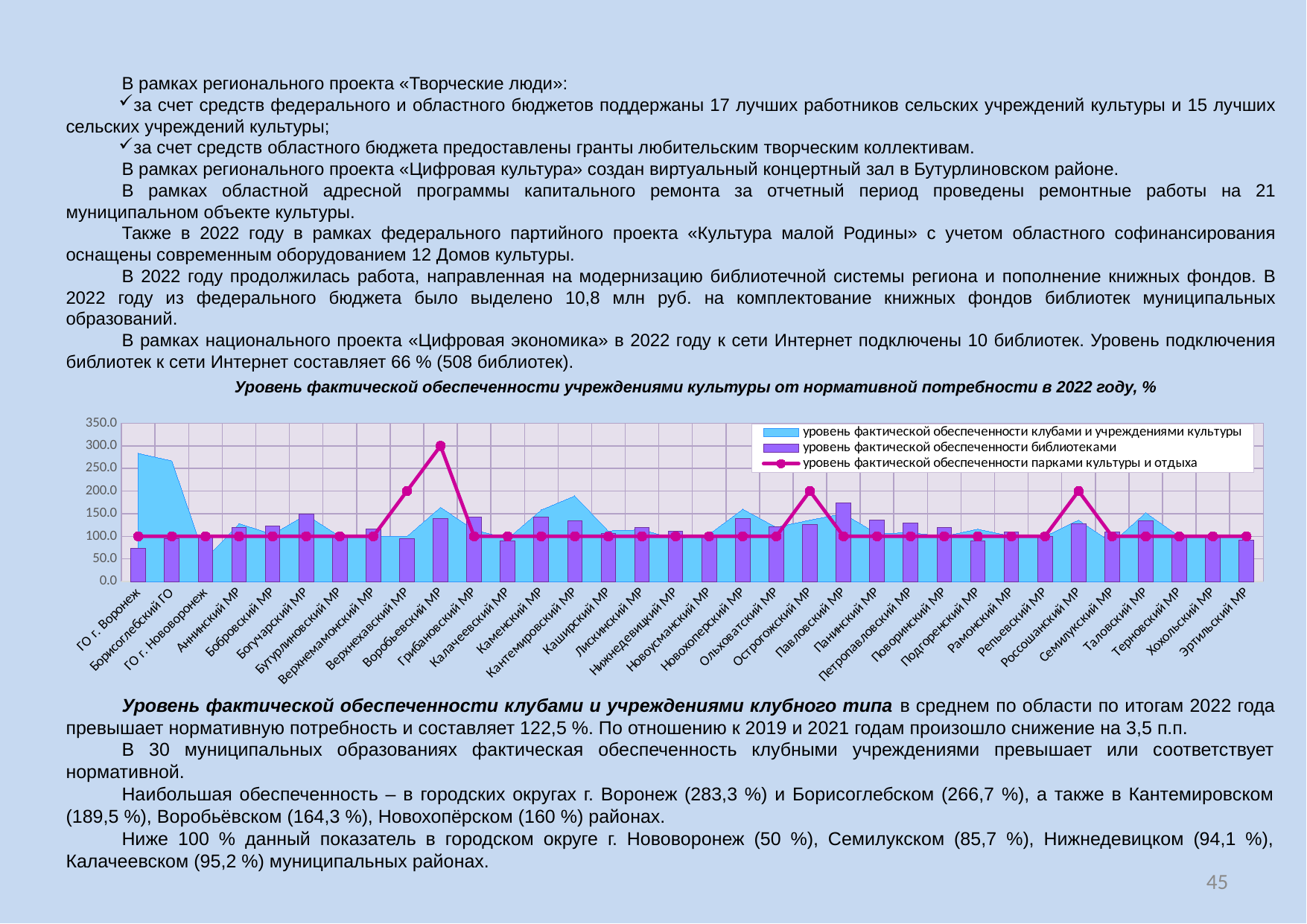
What is the title of the chart? Уровень фактической обеспеченности учреждениями культуры от нормативной потребности в 2022 году, % Which municipality has the highest value for 'уровень фактической обеспеченности клубами и учреждениями культуры'? ГО г. Воронеж Which municipality has the highest value for 'уровень фактической обеспеченности парками культуры и отдыха'? Воробьевский МР What is the value for 'уровень фактической обеспеченности парками культуры и отдыха' for Воробьевский МР? 300.0 What kind of chart is used for the series 'уровень фактической обеспеченности парками культуры и отдыха'? line chart What is the value for 'уровень фактической обеспеченности парками культуры и отдыха' for Верхнехавский МР? 200.0 Is the value for 'уровень фактической обеспеченности клубами и учреждениями культуры' for ГО г. Нововоронеж greater or less than 100? less Is the value for 'уровень фактической обеспеченности клубами и учреждениями культуры' for ГО г. Воронеж greater or less than 250? greater Is the value for 'уровень фактической обеспеченности библиотеками' for ГО г. Воронеж greater or less than 100? less Which has the higher value for 'уровень фактической обеспеченности библиотеками': Павловский МР or Аннинский МР? Павловский МР How many series does the legend list? 3 How many municipalities are shown along the x axis? 34